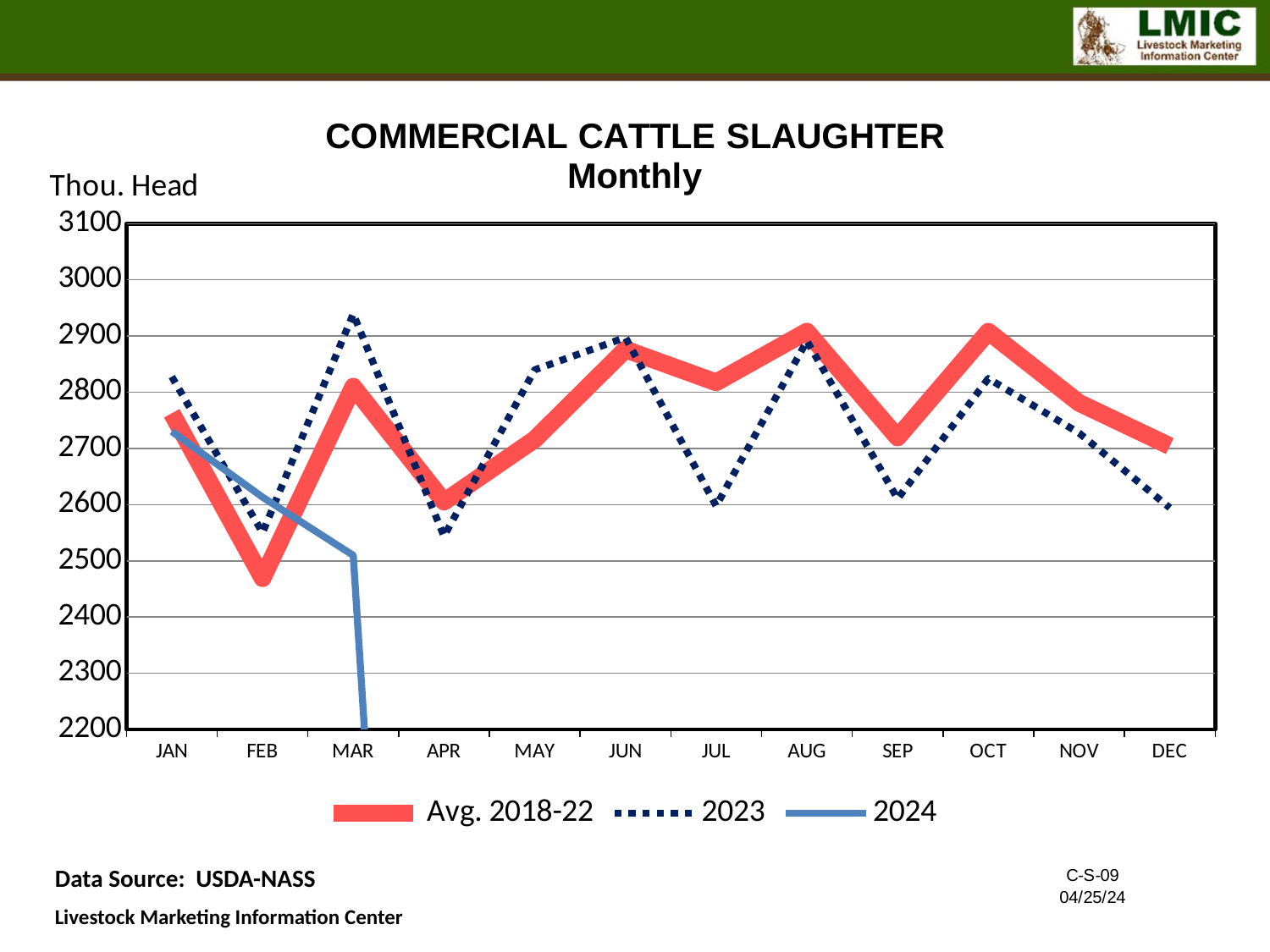
Is the Avg. 2018-22 value for FEB greater or less than 2500? less Which is larger in FEB, the 2024 value or the Avg. 2018-22 value? 2024 Does the 2024 series rise or fall from JAN to MAR? fall Is the 2023 value for MAR greater or less than 2900? greater What unit label is shown above the y axis? Thou. Head Is the 2023 value for JUL greater or less than 2700? less In which month is the Avg. 2018-22 series at its lowest? FEB Which is larger in MAR, the 2023 value or the Avg. 2018-22 value? 2023 How many months are shown along the x axis? 12 What type of chart is shown on the slide? line chart How many series does the legend list? 3 In which month does the 2023 series reach its highest value? MAR